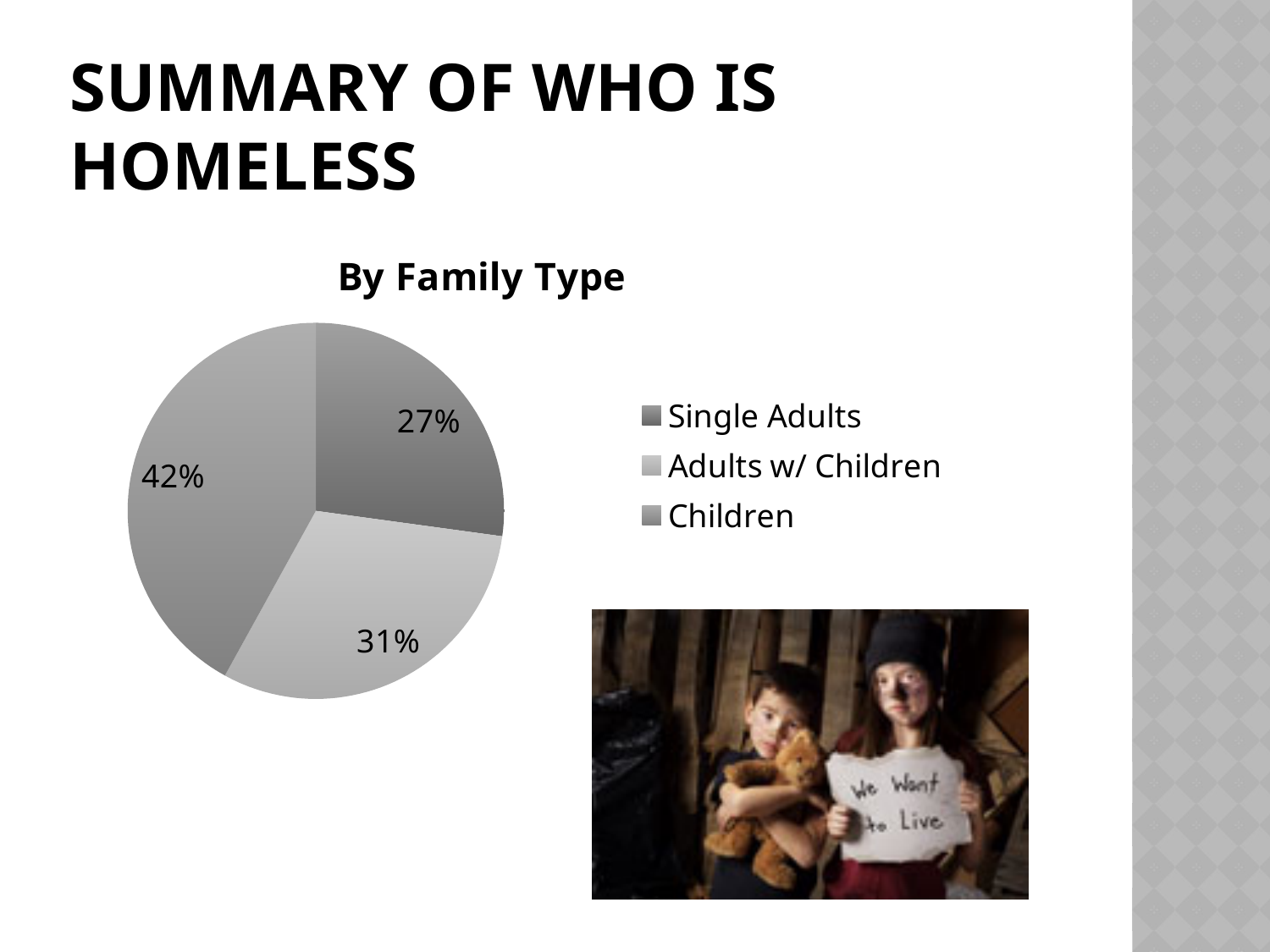
What kind of chart is shown on the slide? Pie chart What is the difference in percentage points between the Adults w/ Children slice and the Single Adults slice? 4 Which is larger, the Adults w/ Children slice or the Single Adults slice? Adults w/ Children What is the title of the chart? By Family Type Which category has the smallest slice of the pie? Single Adults What share of the pie does Single Adults represent? 27% What share of the pie does Adults w/ Children represent? 31% How many categories are shown in the pie chart? 3 Which legend entry is listed first? Single Adults What share of the pie does Children represent? 42% What is the difference in percentage points between the Children slice and the Single Adults slice? 15 Which category has the largest slice of the pie? Children